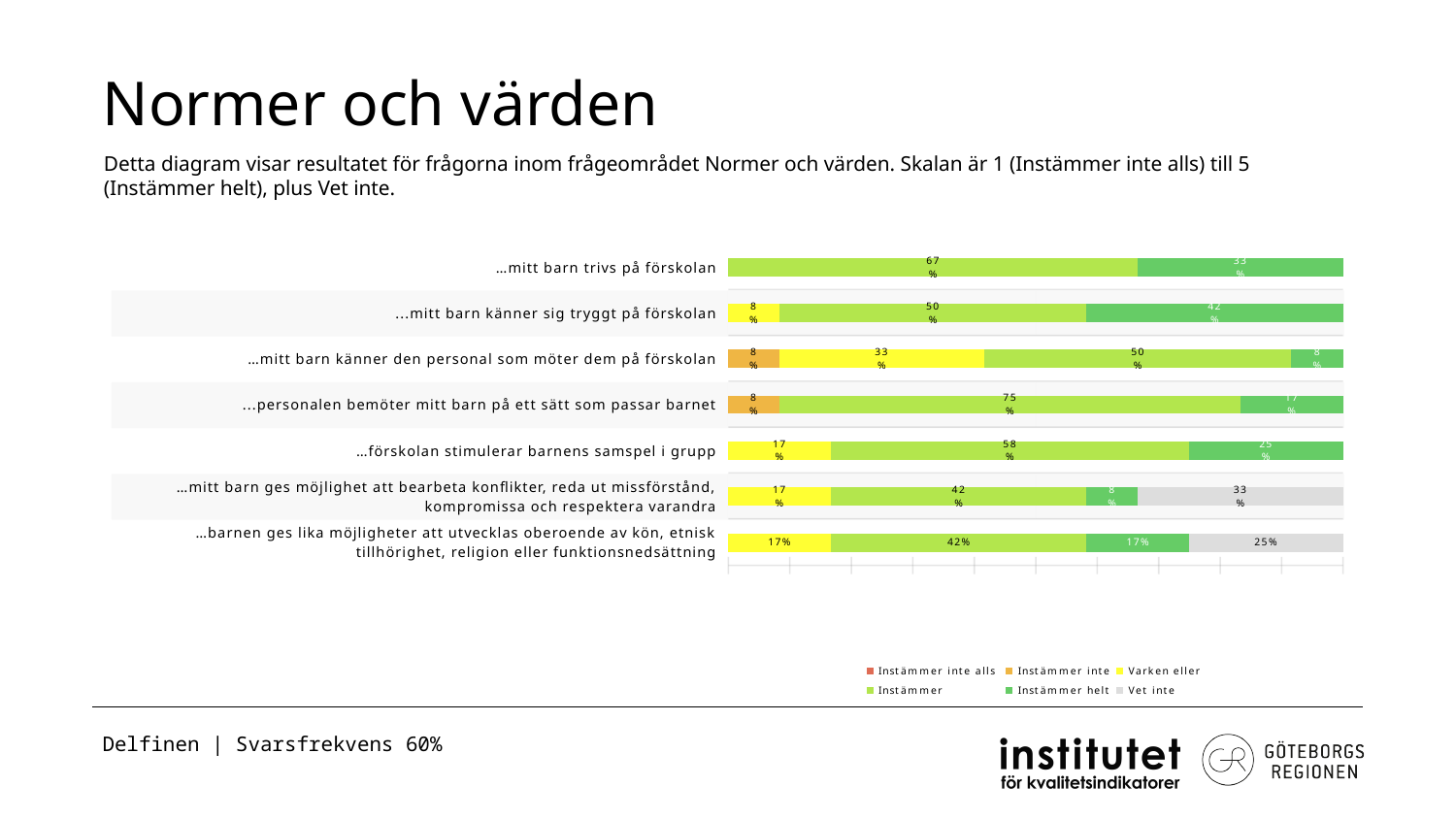
What kind of chart is shown on the slide? Stacked bar chart Which is larger for "…förskolan stimulerar barnens samspel i grupp": the Varken eller value or the Instämmer helt value? Instämmer helt What is the Instämmer value for "…mitt barn trivs på förskolan"? 67% What is the Vet inte value for "…mitt barn ges möjlighet att bearbeta konflikter, reda ut missförstånd, kompromissa och respektera varandra"? 33% What is the Vet inte value for "…barnen ges lika möjligheter att utvecklas oberoende av kön, etnisk tillhörighet, religion eller funktionsnedsättning"? 25% What is the difference between the Instämmer and Instämmer helt values for "…mitt barn trivs på förskolan"? 34% How many series does the legend list? 6 How many statements (categories) are plotted in the chart? 7 What is the Instämmer value for "…personalen bemöter mitt barn på ett sätt som passar barnet"? 75% What is the Instämmer helt value for "…mitt barn känner sig tryggt på förskolan"? 42% What is the title of the slide containing the chart? Normer och värden Which statement has the highest Instämmer value? …personalen bemöter mitt barn på ett sätt som passar barnet